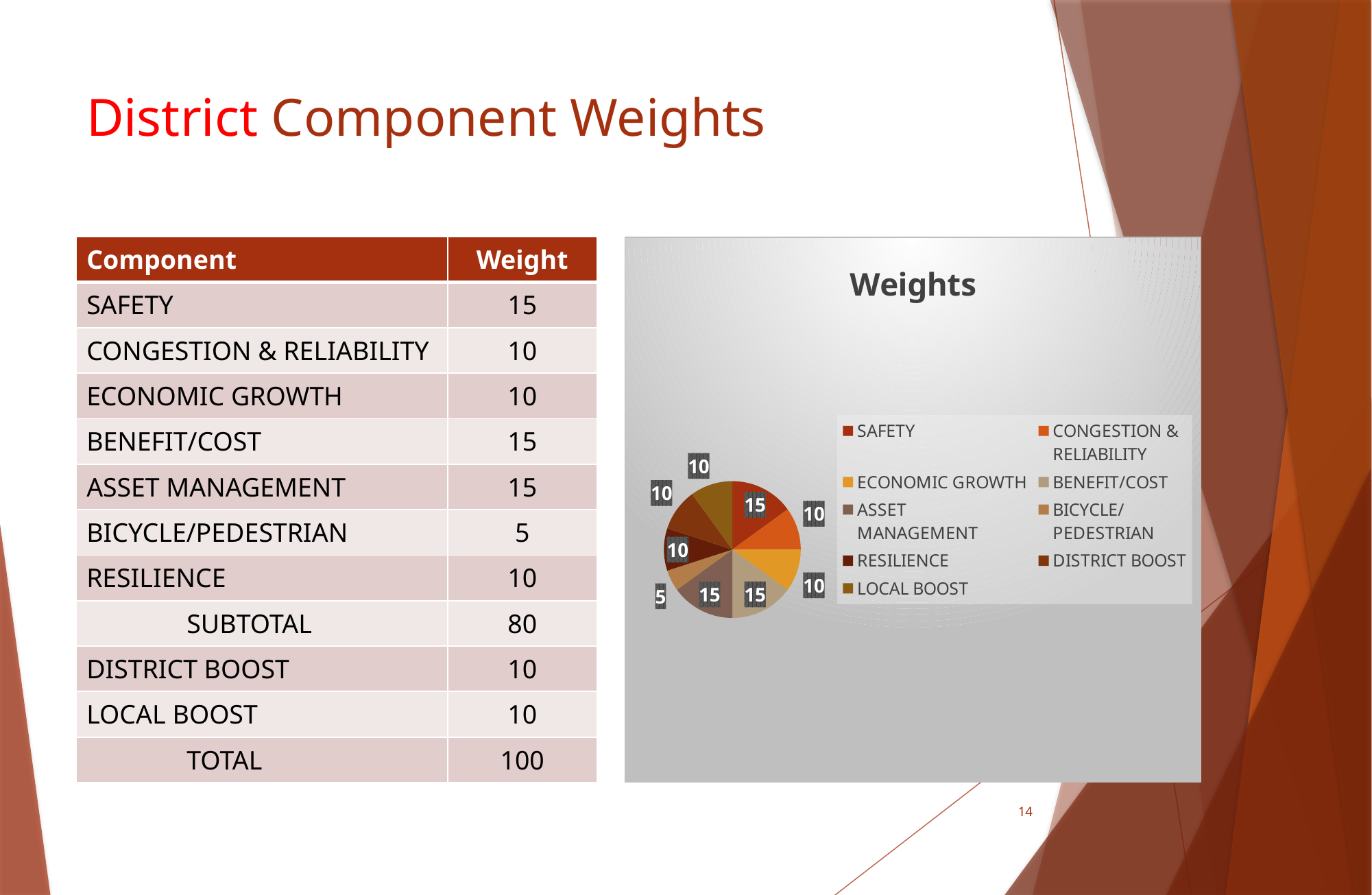
What is the title of the chart? Weights Which has a larger weight, ASSET MANAGEMENT or ECONOMIC GROWTH? ASSET MANAGEMENT What is the weight for RESILIENCE in the pie chart? 10 What is the weight for BICYCLE/PEDESTRIAN in the pie chart? 5 How many entries does the chart legend list? 9 How many slices does the pie chart have? 9 What is the weight for SAFETY in the pie chart? 15 What is the difference between the weights for SAFETY and BICYCLE/PEDESTRIAN? 10 Which component has the smallest slice in the pie chart? BICYCLE/PEDESTRIAN What share of the pie does BENEFIT/COST represent? 15% What is the total of all the slices in the pie chart? 100 What kind of chart is shown on the slide? pie chart